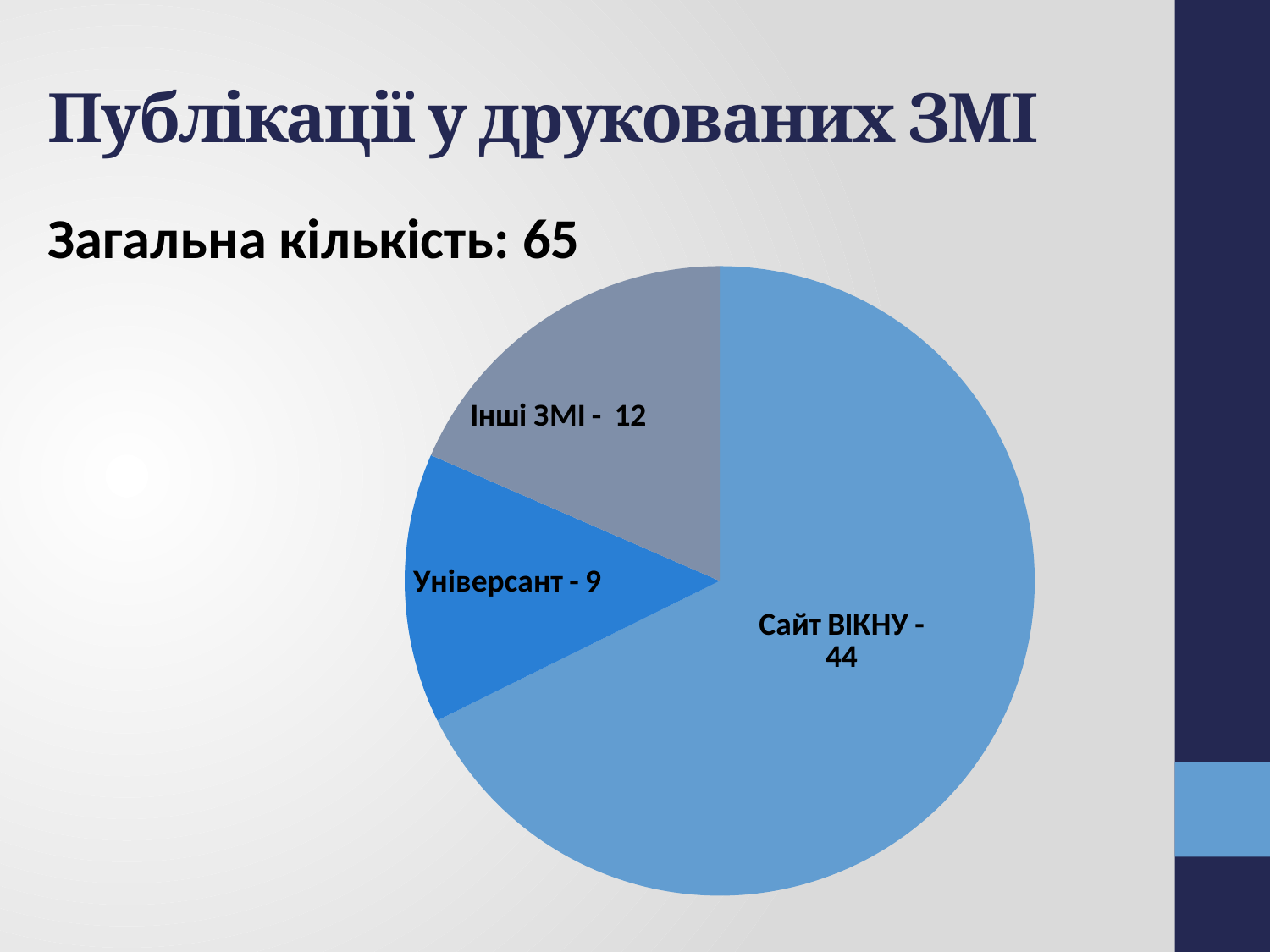
Which is larger, the value for Інші ЗМІ or the value for Універсант? Інші ЗМІ How many slices does the pie chart have? 3 What is the difference between the values for Сайт ВІКНУ and Інші ЗМІ? 32 What is the title of the slide containing the pie chart? Публікації у друкованих ЗМІ What is the value for Універсант? 9 What is the value for Інші ЗМІ? 12 What is the difference between the values for Інші ЗМІ and Універсант? 3 What is the total of all slices in the pie chart? 65 Which category has the largest slice of the pie? Сайт ВІКНУ Which category has the smallest slice of the pie? Універсант What type of chart is shown on the slide? pie chart What is the value for Сайт ВІКНУ? 44